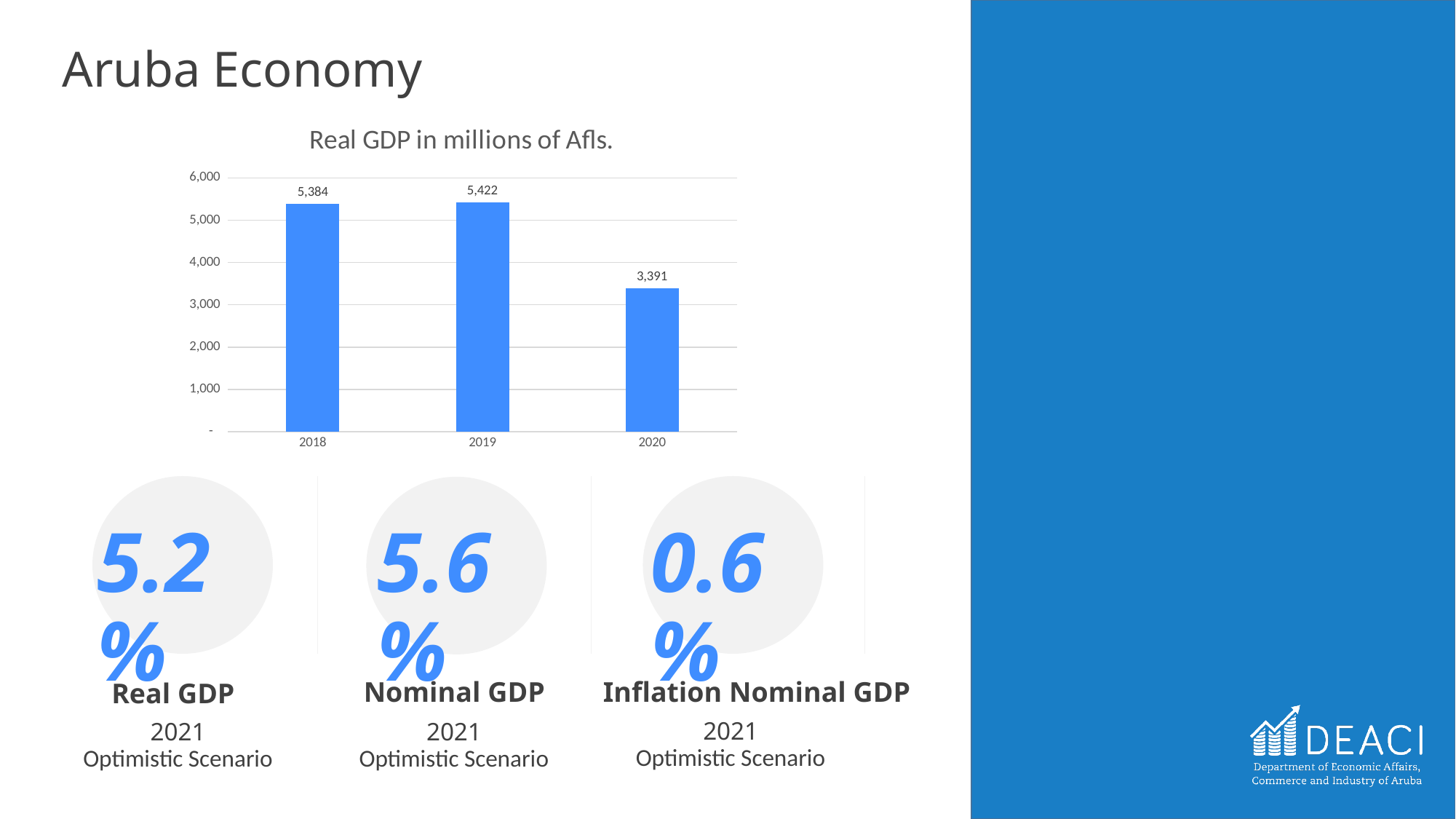
Which year has the highest Real GDP? 2019 What is the Real GDP value for 2019? 5,422 Which year has the lowest Real GDP? 2020 What is the title of the chart? Real GDP in millions of Afls. Which is larger, the Real GDP in 2018 or in 2020? 2018 What is the Real GDP value for 2018? 5,384 What is the difference between the Real GDP in 2019 and 2020? 2,031 What kind of chart is shown on the slide? bar chart Is the Real GDP value for 2020 greater or less than 4,000? less How many years are shown in the chart? 3 What is the Real GDP value for 2020? 3,391 What is the difference between the Real GDP in 2018 and 2020? 1,993